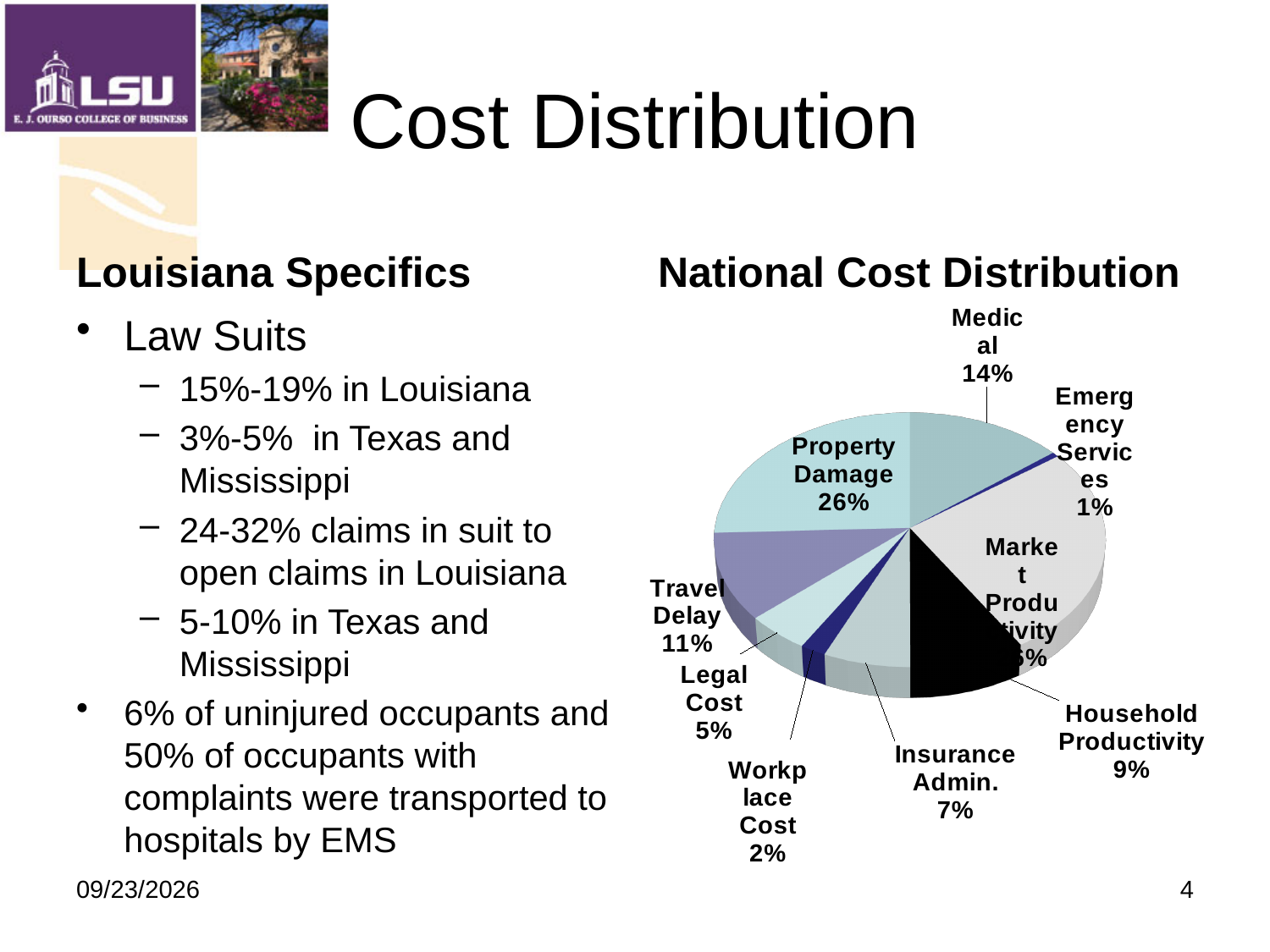
In the National Cost Distribution pie chart, which category has the smallest share? Emergency Services In the National Cost Distribution pie chart, what share is Medical? 14% In the National Cost Distribution pie chart, what share is Insurance Admin.? 7% In the National Cost Distribution pie chart, what share is Property Damage? 26% How many slices does the National Cost Distribution pie chart have? 9 In the National Cost Distribution pie chart, how many percentage points larger is Property Damage than Travel Delay? 15 What is the title of the pie chart on the slide? National Cost Distribution In the National Cost Distribution pie chart, what share is Workplace Cost? 2% In the National Cost Distribution pie chart, what share is Travel Delay? 11% What kind of chart is shown under the heading National Cost Distribution? pie chart In the National Cost Distribution pie chart, which is larger: Medical or Household Productivity? Medical In the National Cost Distribution pie chart, what share is Household Productivity? 9%